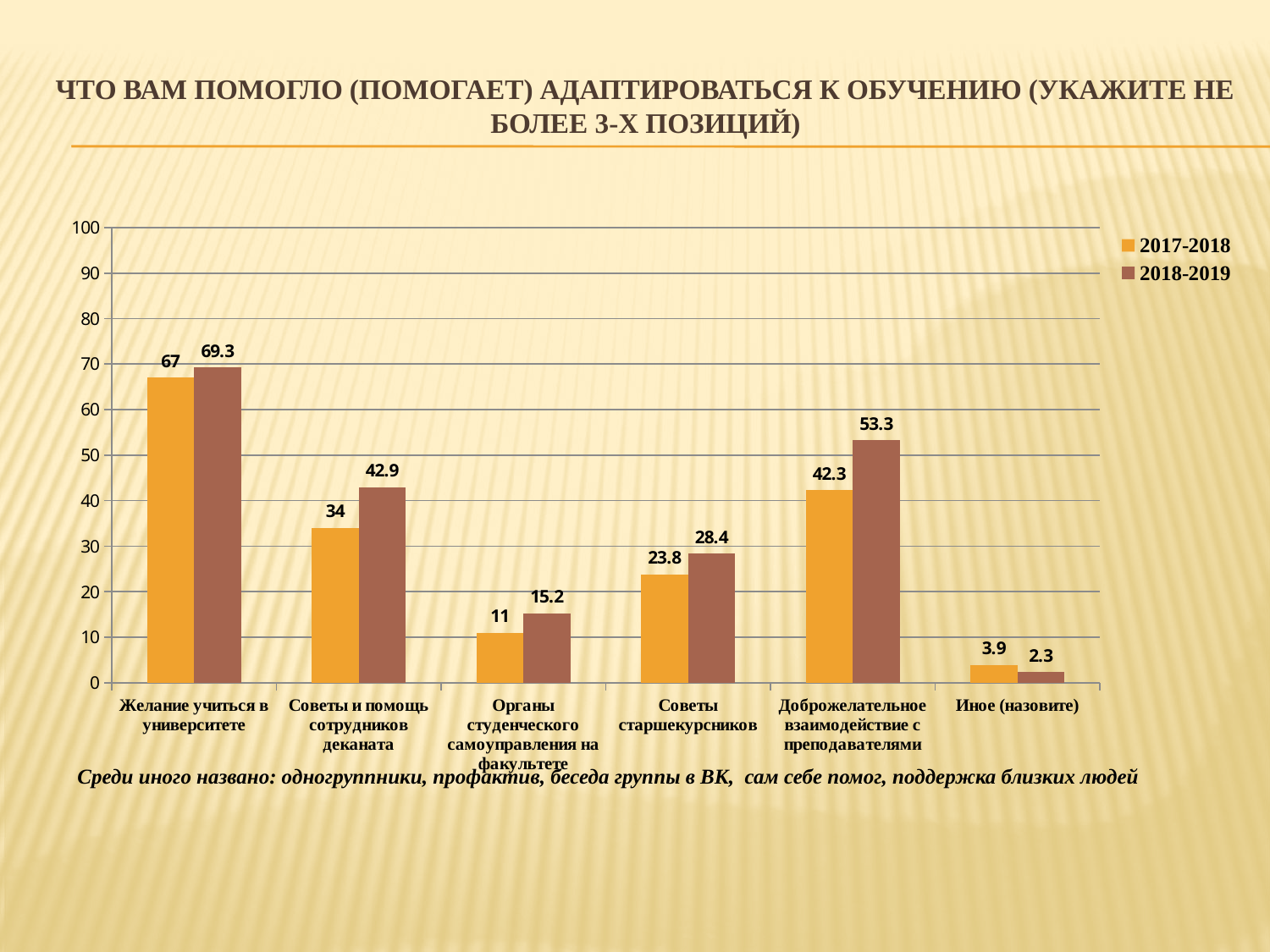
What is the value for "Органы студенческого самоуправления на факультете" in the 2018-2019 series? 15.2 What is the value for "Желание учиться в университете" in the 2017-2018 series? 67 Is the 2017-2018 value for "Советы старшекурсников" greater or less than 30? less What is the value for "Доброжелательное взаимодействие с преподавателями" in the 2018-2019 series? 53.3 Which category has the highest value in the 2018-2019 series? Желание учиться в университете Which category has the lowest value in the 2017-2018 series? Иное (назовите) Which is larger for "Иное (назовите)": the 2017-2018 value or the 2018-2019 value? 2017-2018 What is the difference between the 2018-2019 and 2017-2018 values for "Советы и помощь сотрудников деканата"? 8.9 How many categories are shown on the x axis? 6 Which series is shown in orange in the legend? 2017-2018 How many series does the legend list? 2 What kind of chart is shown on the slide? bar chart